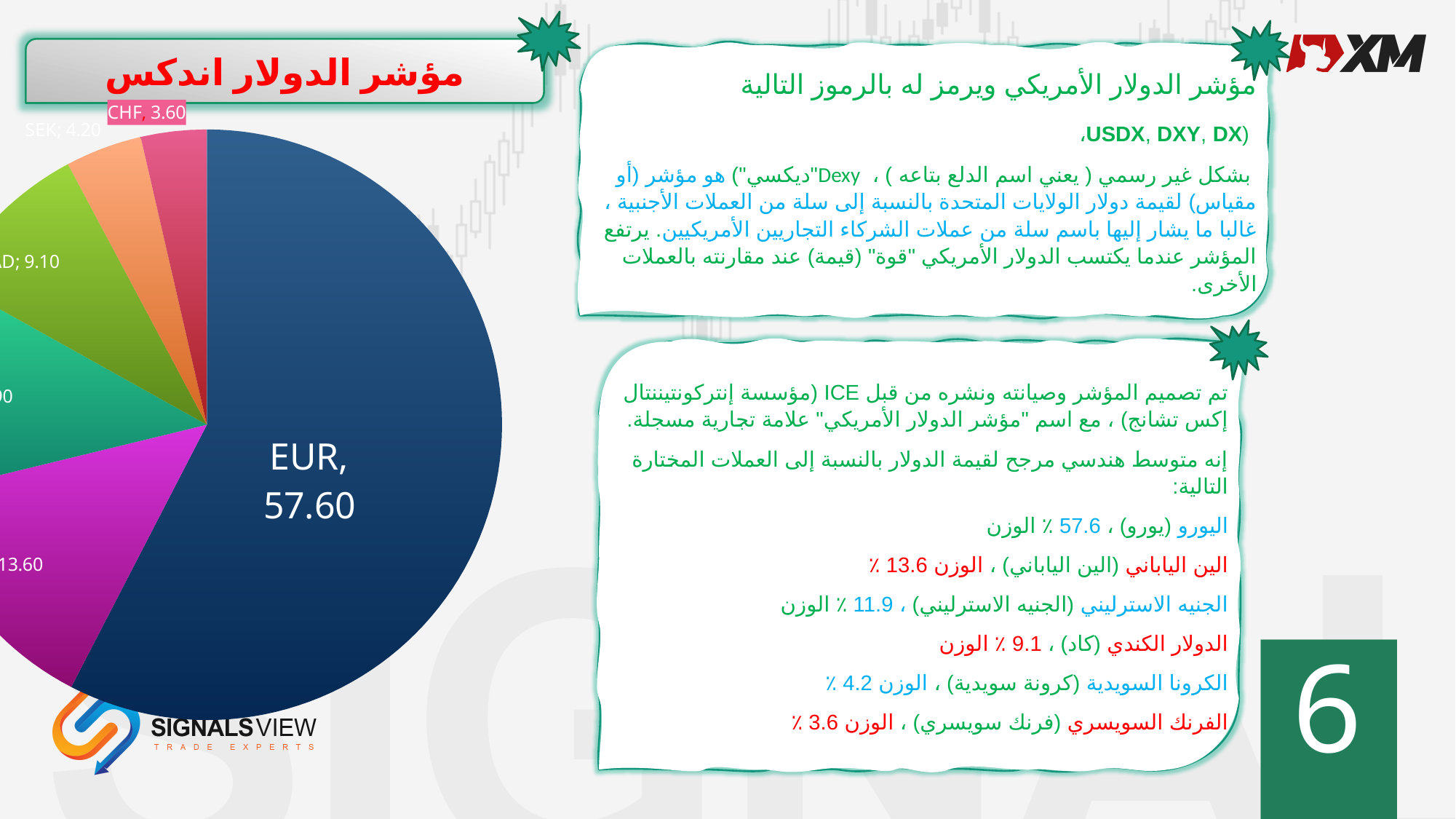
What is the difference between the EUR value and the CHF value in the pie chart? 54.00 What is the title of the chart? مؤشر الدولار اندكس What is the value shown for CHF in the pie chart? 3.60 What kind of chart is shown on the slide? pie chart What colour is the EUR slice in the pie chart? dark blue What is the difference between the SEK value and the CHF value in the pie chart? 0.60 Which is larger in the pie chart, SEK or CHF? SEK What is the value shown for EUR in the pie chart? 57.60 What is the value shown for SEK in the pie chart? 4.20 Which category has the largest slice in the pie chart? EUR